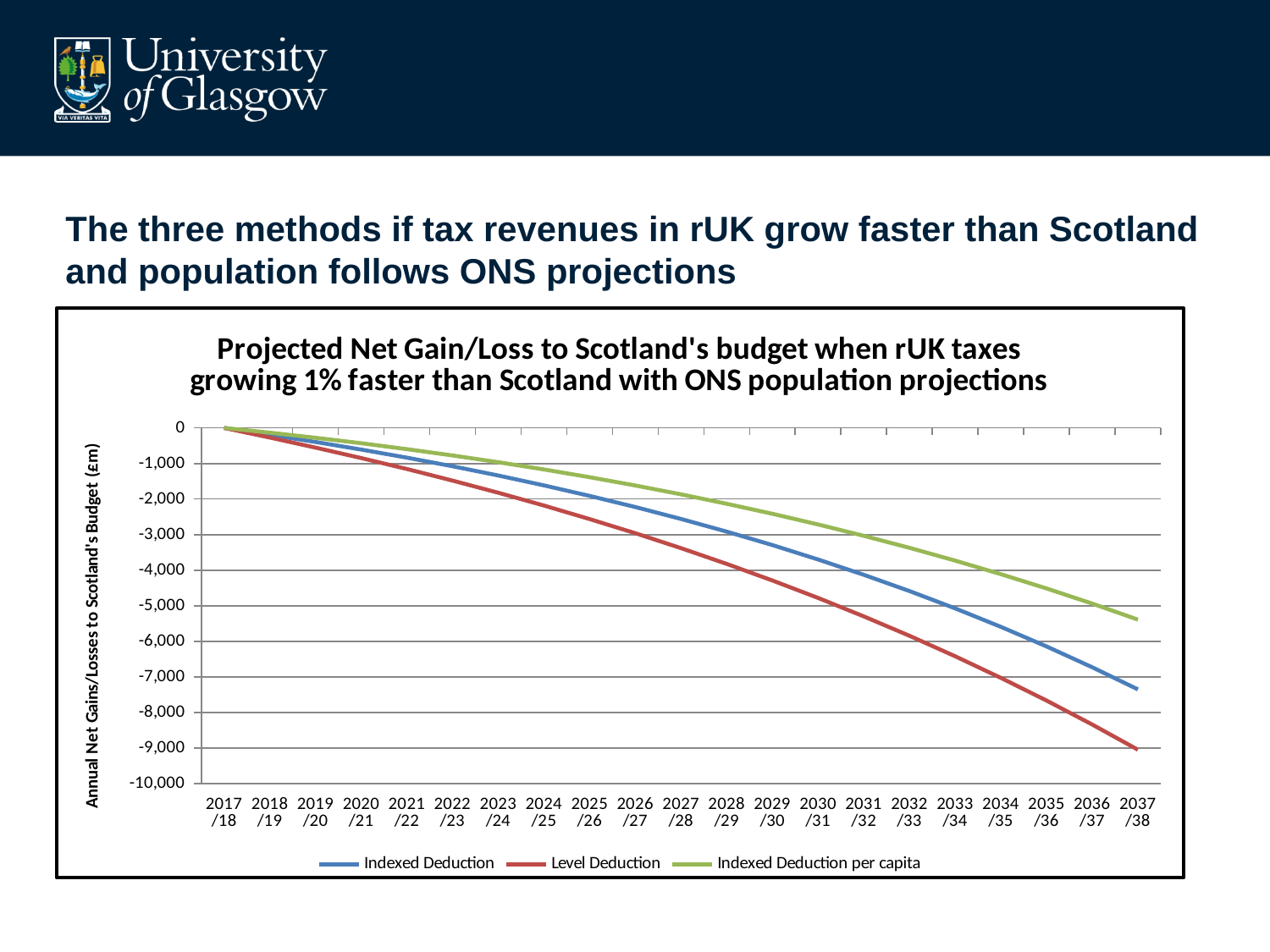
How many years are shown along the x axis? 21 Is the value for Indexed Deduction per capita in 2037/38 greater or less than -6,000? greater Which series has the highest value in 2037/38? Indexed Deduction per capita Is the value for Indexed Deduction in 2037/38 greater or less than -6,000? less How many series does the legend list? 3 What is the value for all three series in 2017/18? 0 Which series has the lowest value in 2037/38? Level Deduction Is the value for Level Deduction in 2037/38 greater or less than -8,000? less Do the values for Level Deduction rise or fall from 2017/18 to 2037/38? fall What kind of chart is shown on the slide? line chart What is the label on the vertical axis of the chart? Annual Net Gains/Losses to Scotland's Budget (£m) In 2037/38, which is larger: the value for Indexed Deduction or the value for Level Deduction? Indexed Deduction